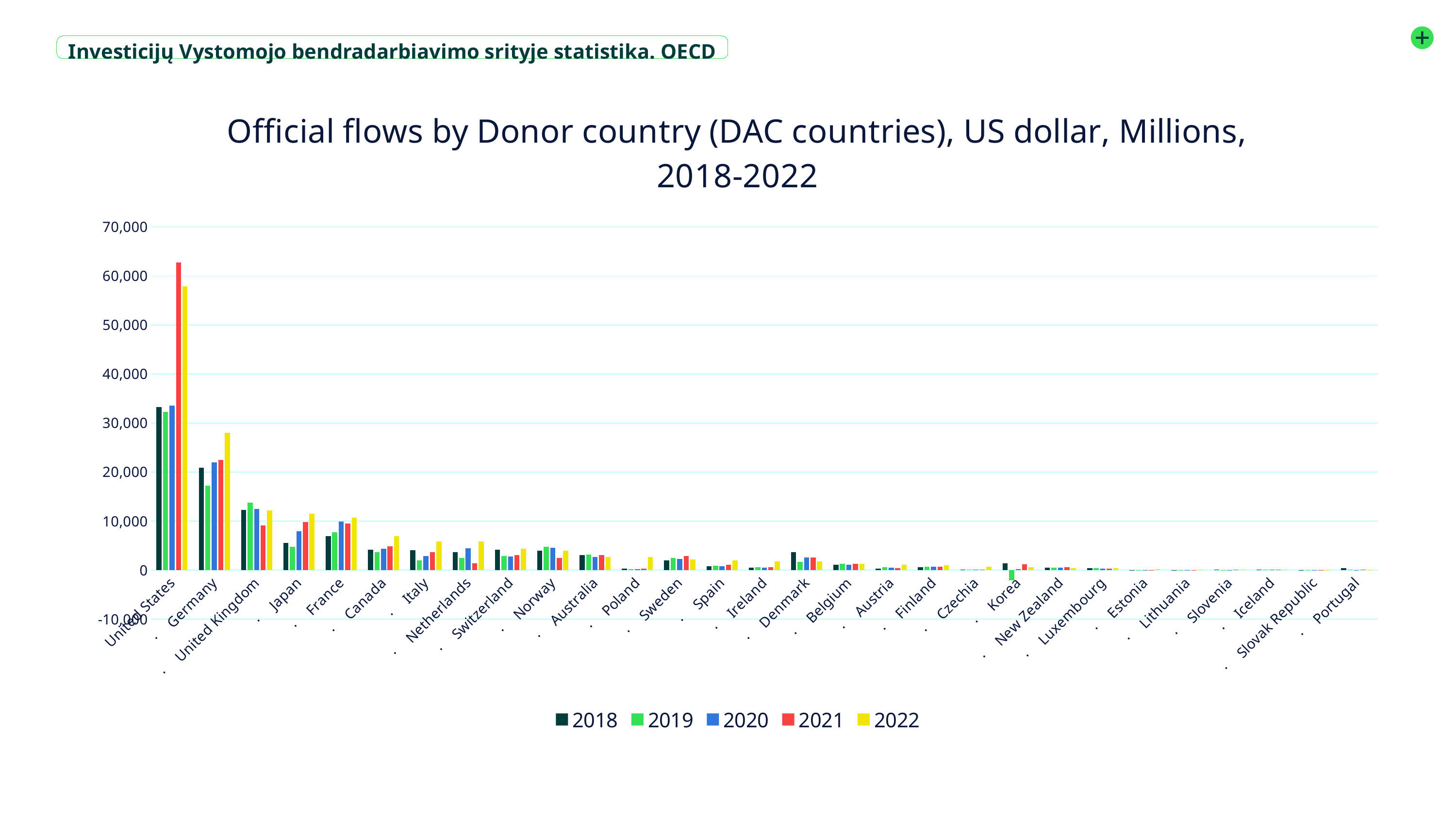
What kind of chart is shown on the slide? Bar chart For the United States, which year has the highest bar? 2021 Is the value for Germany in 2022 greater or less than 30,000? less How many series does the legend list? 5 For Germany, which is larger: the 2019 value or the 2022 value? 2022 Is the value for the United Kingdom in 2019 greater or less than 10,000? greater Is the value for Japan in 2018 greater or less than 10,000? less How many donor countries are shown on the x axis? 29 Which donor country has the tallest bar in the chart? United States Which donor country has a bar that falls below zero? Korea Which colour represents the year 2022 in the legend? Yellow